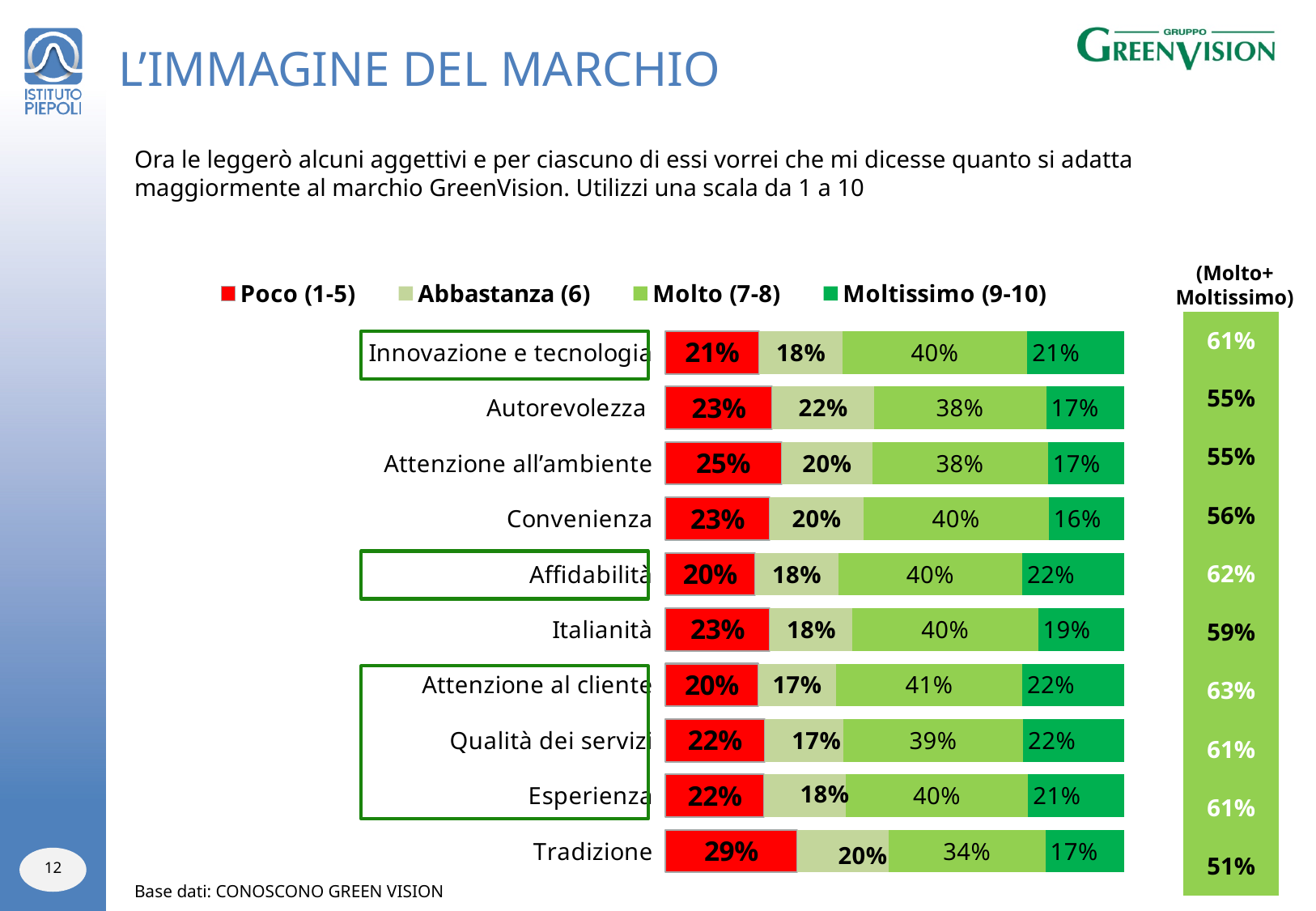
Which category has the highest Molto+Moltissimo value in the right-hand column? Attenzione al cliente What is the Poco (1-5) value for Tradizione? 29% What type of chart is shown on the slide? Stacked bar chart How many series does the legend list? 4 What is the Molto (7-8) value for Attenzione al cliente? 41% Which is larger: the Moltissimo (9-10) value for Affidabilità or for Italianità? Affidabilità Which category has the highest Poco (1-5) value? Tradizione How many categories (adjectives) are plotted in the chart? 10 Which category has the lowest Moltissimo (9-10) value? Convenienza What is the total of the stacked bar for Innovazione e tecnologia? 100% What is the Abbastanza (6) value for Autorevolezza? 22% What is the difference between the Poco (1-5) value for Tradizione and the Poco (1-5) value for Affidabilità? 9 percentage points